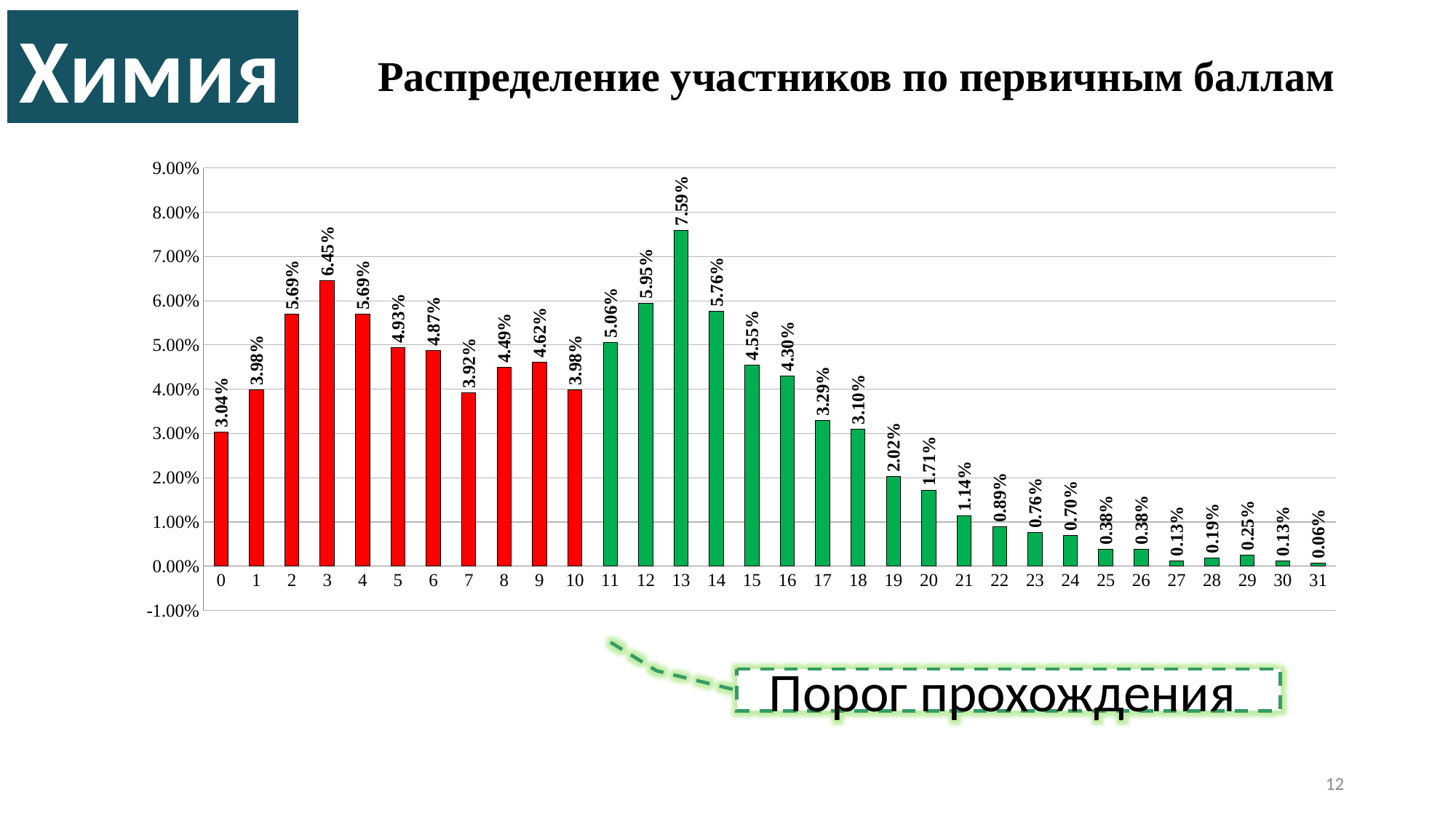
Which is larger, the value for score 12 or the value for score 14? score 12 Which score has the highest share of participants? 13 What is the value for score 0? 3.04% Do the values rise or fall from score 13 to score 31? fall What is the value for score 13? 7.59% What colour are the bars for scores 0 to 10? red What is the value for score 22? 0.89% What kind of chart is shown on the slide? bar chart What is the difference between the values for score 13 and score 3? 1.14% How many score categories are shown on the x axis? 32 Which score has the lowest share of participants? 31 Is the value for score 19 greater or less than 3.00%? less